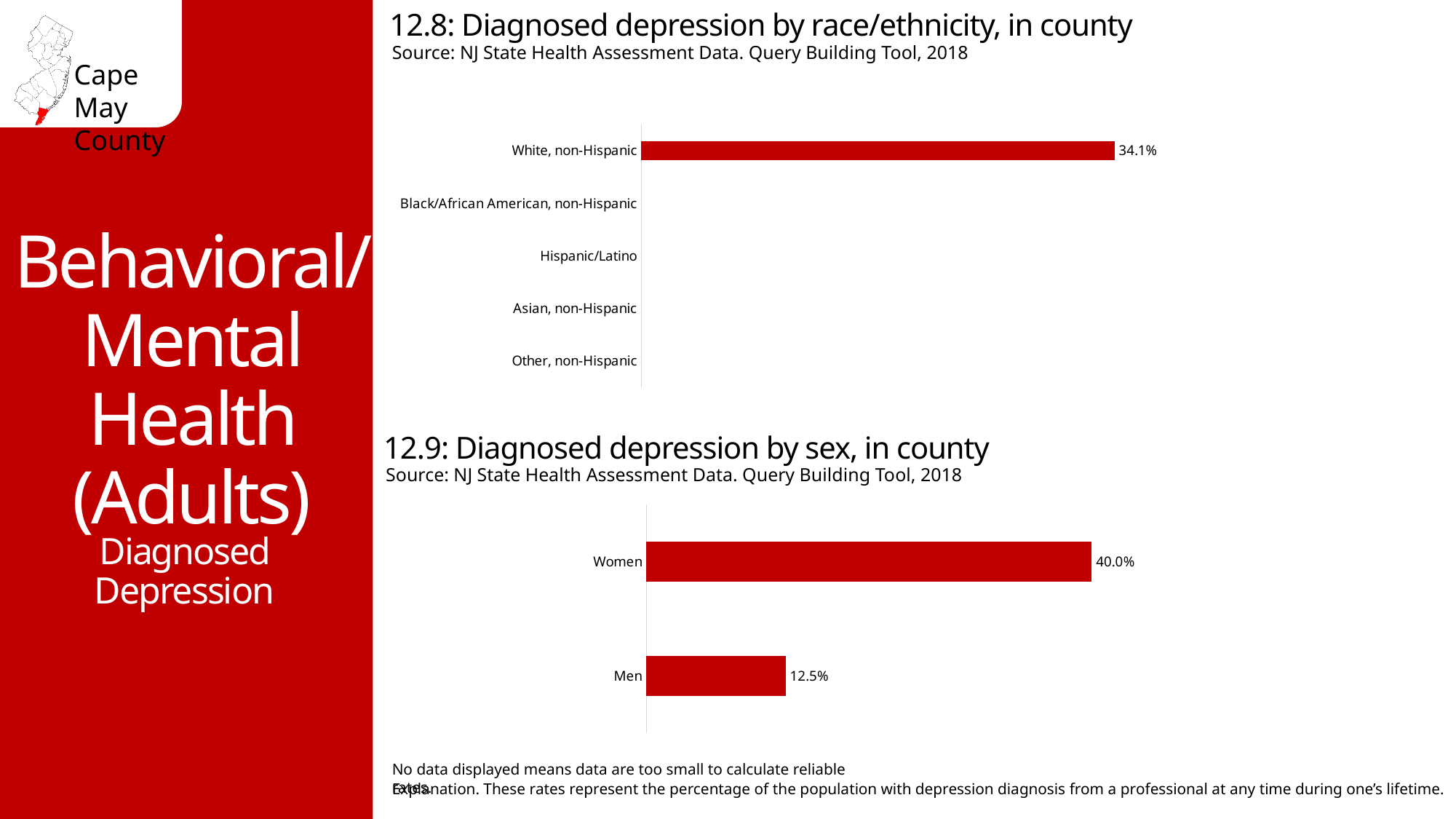
In the chart '12.9: Diagnosed depression by sex, in county', what is the value for Men? 12.5% In the chart '12.9: Diagnosed depression by sex, in county', which category has the highest value? Women In the chart '12.9: Diagnosed depression by sex, in county', is the value for Women or Men larger? Women In the chart '12.9: Diagnosed depression by sex, in county', what is the value for Women? 40.0% In the chart '12.8: Diagnosed depression by race/ethnicity, in county', which category is the only one with a bar displayed? White, non-Hispanic What kind of chart is '12.9: Diagnosed depression by sex, in county'? Bar chart In the chart '12.8: Diagnosed depression by race/ethnicity, in county', how many race/ethnicity categories are listed on the axis? 5 In the chart '12.9: Diagnosed depression by sex, in county', what is the difference between the values for Women and Men? 27.5% In the chart '12.9: Diagnosed depression by sex, in county', how many categories are shown? 2 In the chart '12.8: Diagnosed depression by race/ethnicity, in county', what is the value for White, non-Hispanic? 34.1% In the chart '12.9: Diagnosed depression by sex, in county', which category has the lowest value? Men What kind of chart is '12.8: Diagnosed depression by race/ethnicity, in county'? Bar chart